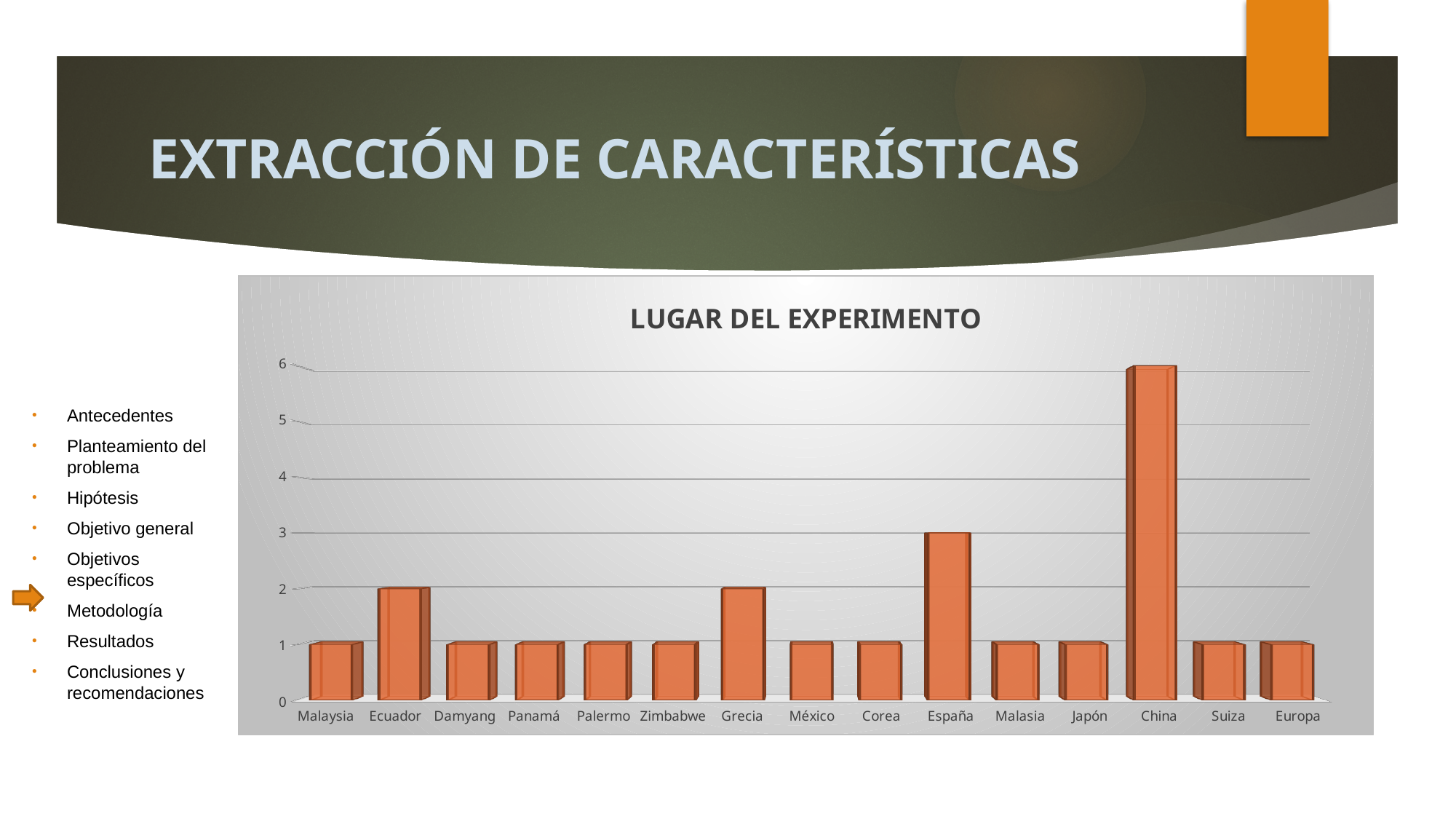
What is the value for China? 6 What kind of chart is shown on the slide? bar chart What is the value for España? 3 Which is larger, the value for España or the value for Grecia? España What is the value for Ecuador? 2 What is the title of the chart? LUGAR DEL EXPERIMENTO Is the value for China greater or less than 5? greater What is the value for Grecia? 2 What is the difference between the values for China and España? 3 What is the value for Japón? 1 Which category has the highest value in the chart? China How many categories are shown on the x axis of the chart? 15